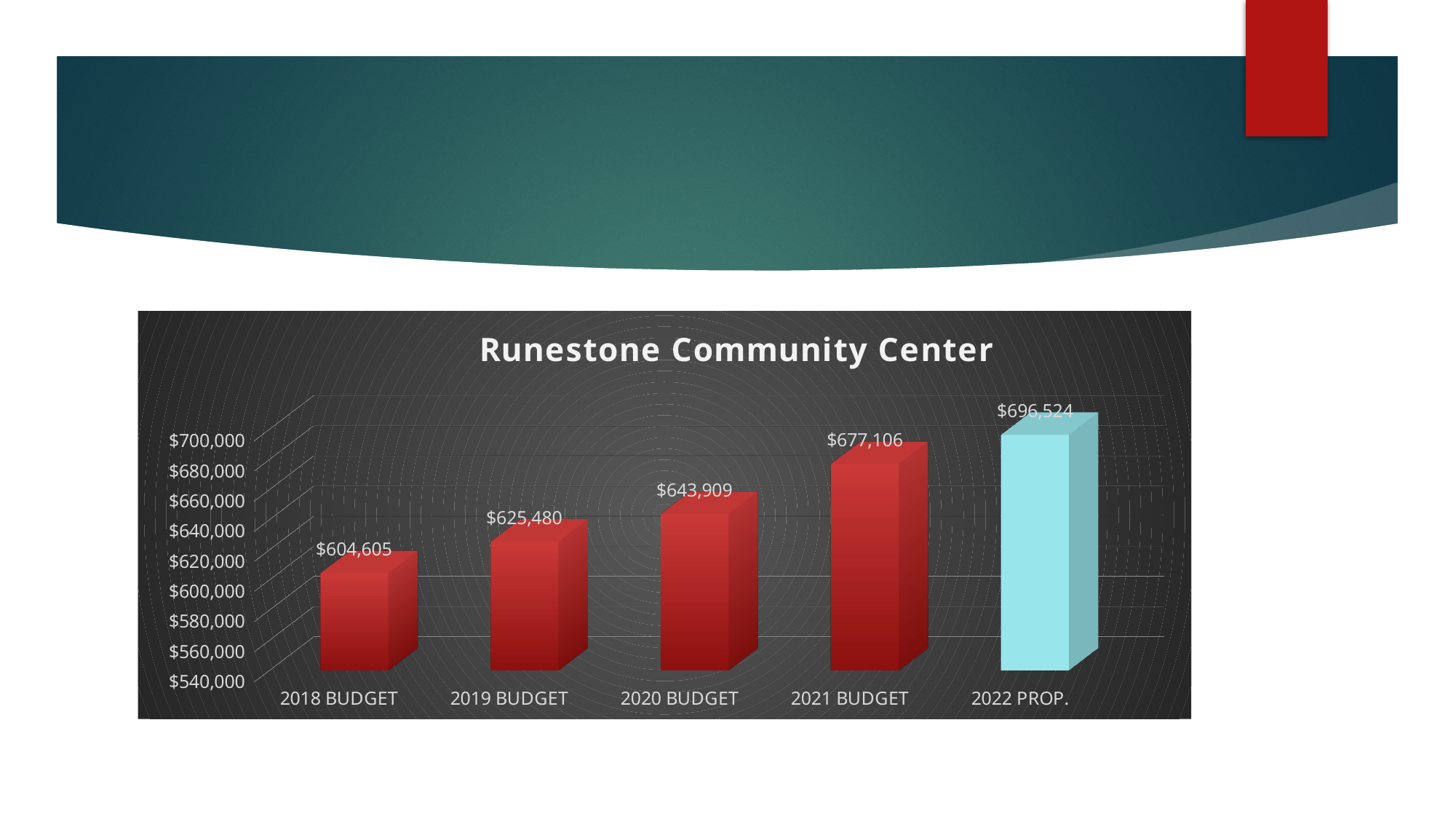
What is the value for 2018 BUDGET? $604,605 Do the values rise or fall from 2018 BUDGET to 2022 PROP.? Rise What is the difference between the 2022 PROP. and the 2018 BUDGET values? $91,919 What is the difference between the 2021 BUDGET and the 2020 BUDGET values? $33,197 What is the value for 2020 BUDGET? $643,909 What is the value for 2022 PROP.? $696,524 Which category has the highest value? 2022 PROP. What is the title of the chart? Runestone Community Center How many categories are shown on the x axis? 5 Which is larger, the 2019 BUDGET value or the 2021 BUDGET value? 2021 BUDGET What kind of chart is this? Bar chart Which category has the lowest value? 2018 BUDGET